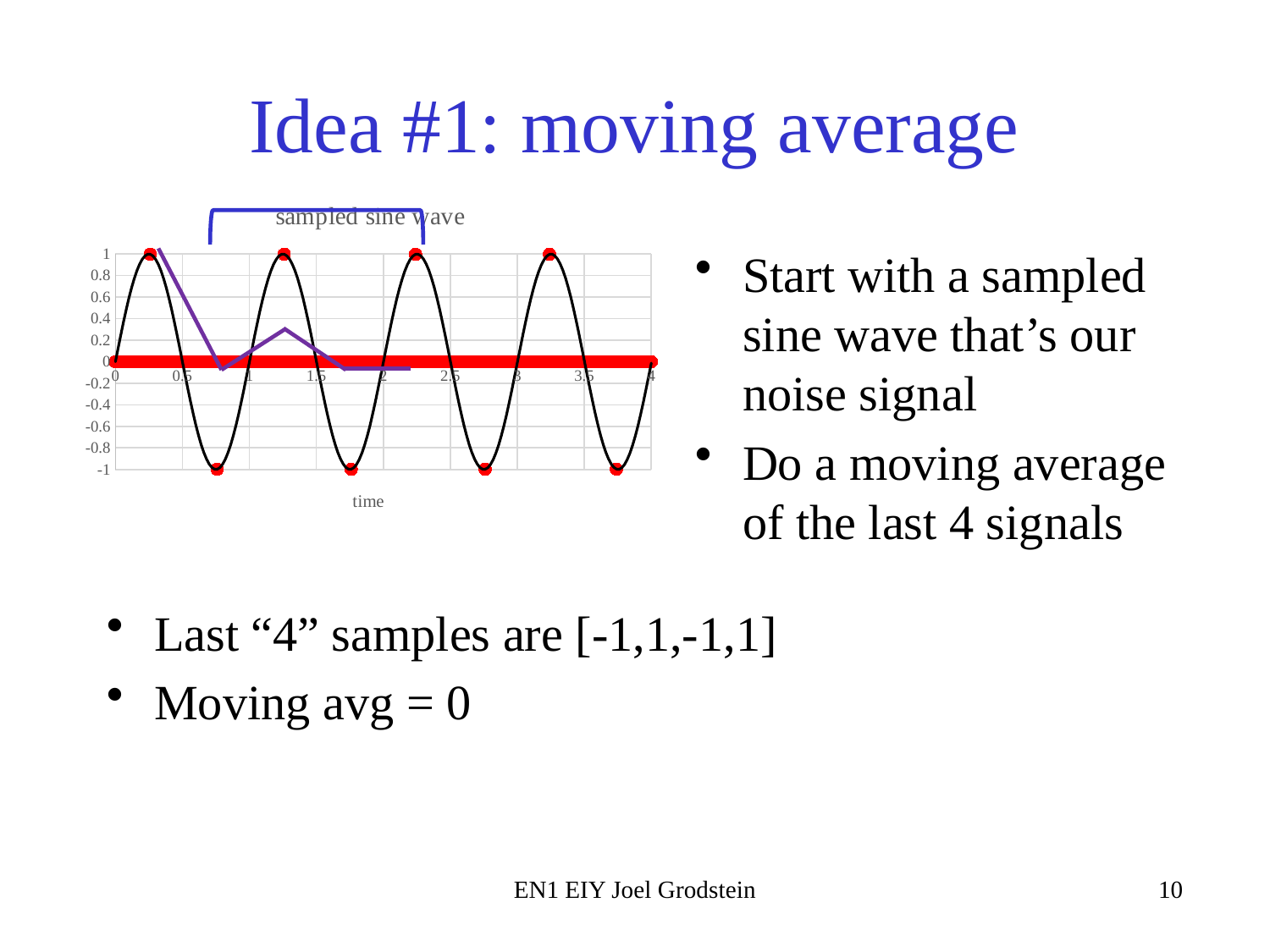
What is the highest value shown on the y axis of the chart? 1 How many peaks does the black sine curve have across the plotted time range? 4 What is the maximum value reached by the black sine curve? 1 Is the value of the black sine curve at time 0.25 greater or less than 0? greater What is the largest tick value on the x axis? 4 What is the lowest value shown on the y axis of the chart? -1 What is the title of the chart? sampled sine wave What is the label on the x axis of the chart? time What is the difference between the maximum and minimum values of the black sine curve? 2 How many troughs does the black sine curve have across the plotted time range? 4 What kind of chart is shown on the slide? line chart What is the minimum value reached by the black sine curve? -1